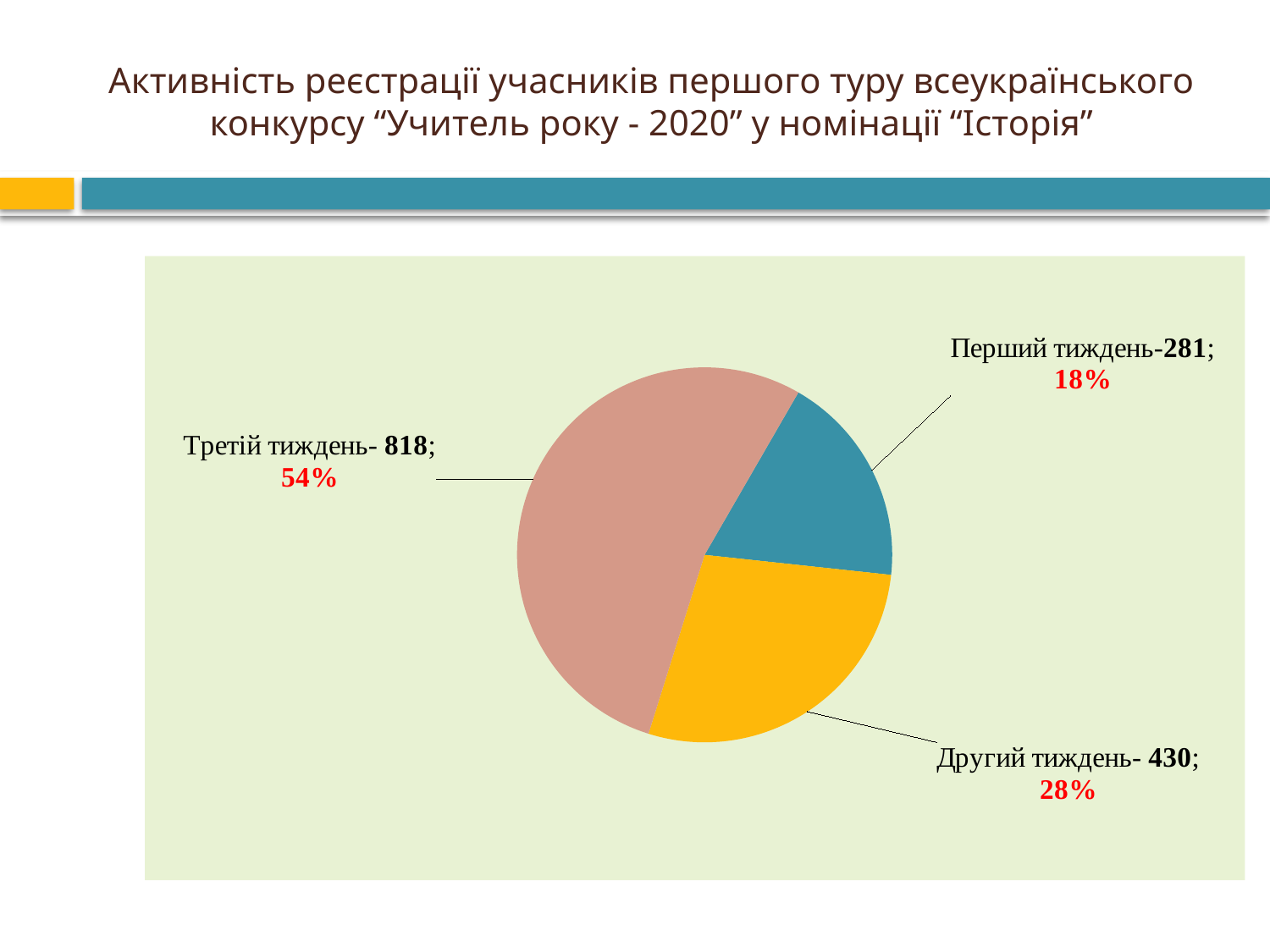
What is the difference between the values for Третій тиждень and Другий тиждень? 388 What is the value for Перший тиждень? 281 What colour is the slice for Другий тиждень? yellow What share of the pie does Перший тиждень represent? 18% Which is larger, the value for Другий тиждень or Перший тиждень? Другий тиждень How many slices does the pie chart have? 3 What is the value for Другий тиждень? 430 Which week has the smallest slice? Перший тиждень Which week has the largest slice? Третій тиждень What kind of chart is shown on the slide? pie chart What is the value for Третій тиждень? 818 What share of the pie does Третій тиждень represent? 54%